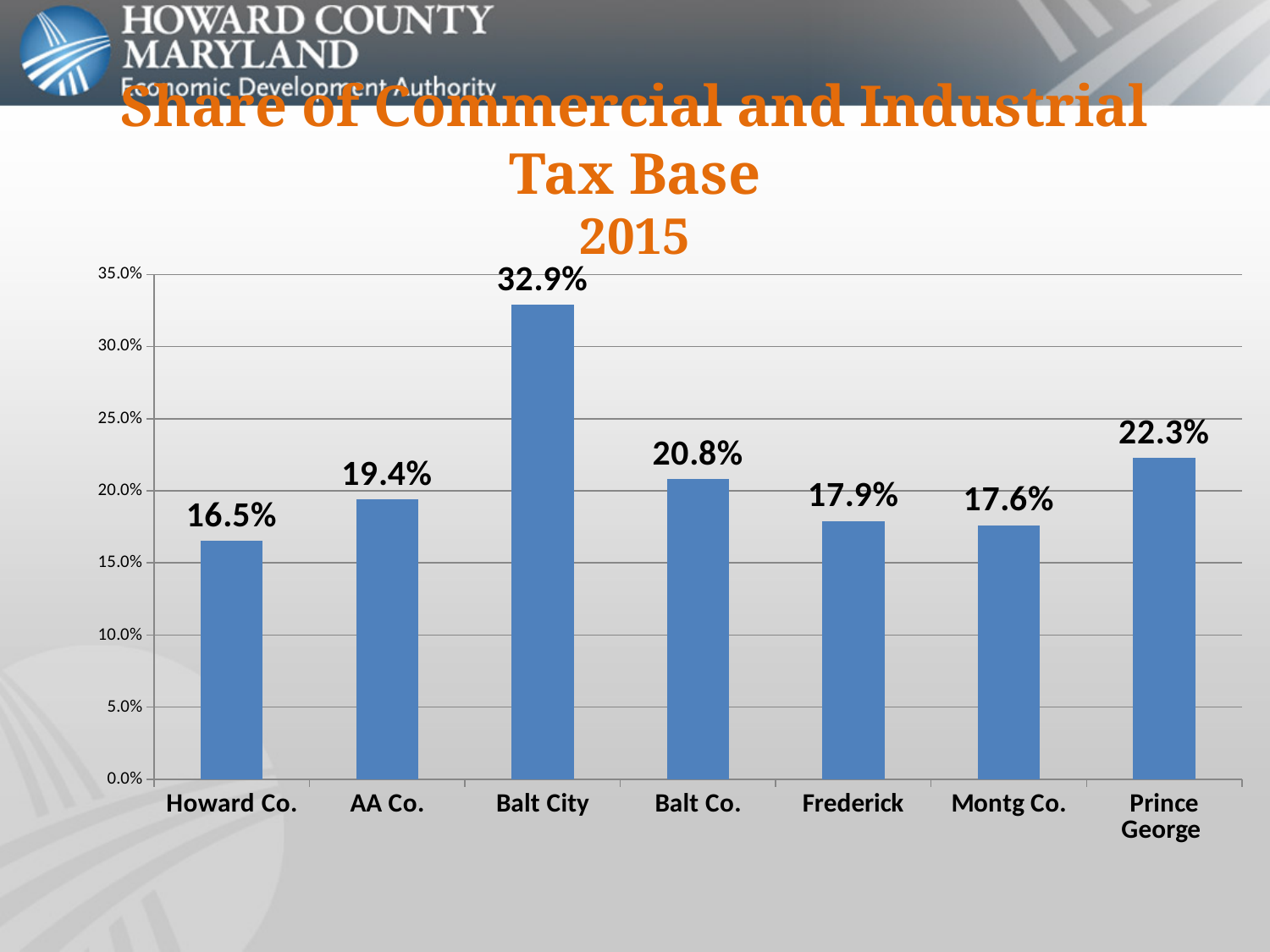
What year does the chart title refer to? 2015 Which category has the highest share of commercial and industrial tax base? Balt City What is the value shown for Prince George? 22.3% What is the value shown for Balt City? 32.9% What is the share of commercial and industrial tax base for Howard Co.? 16.5% What kind of chart is shown on the slide? bar chart Which is larger, the value for AA Co. or the value for Montg Co.? AA Co. Is the value for Balt Co. greater or less than 20.0%? greater Which category has the lowest share of commercial and industrial tax base? Howard Co. What is the difference between the values for Balt City and Howard Co.? 16.4% How many categories are shown on the x axis? 7 What is the difference between the values for Prince George and Balt Co.? 1.5%